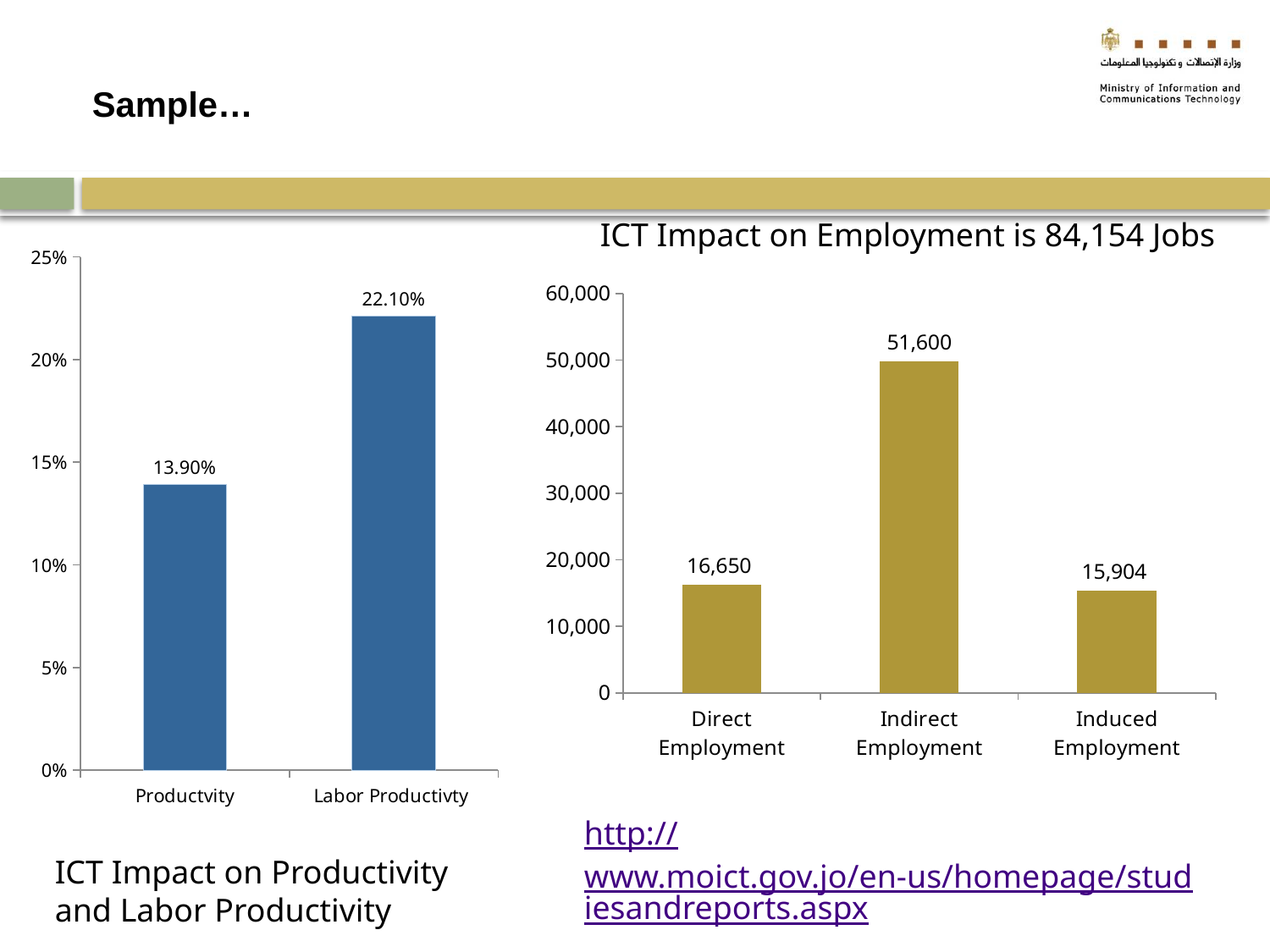
In the right chart (ICT Impact on Employment is 84,154 Jobs), what is the value for Induced Employment? 15,904 In the left chart (ICT Impact on Productivity and Labor Productivity), what is the difference between Labor Productivty and Productvity? 8.20% In the right chart (ICT Impact on Employment is 84,154 Jobs), what is the value for Indirect Employment? 51,600 In the left chart (ICT Impact on Productivity and Labor Productivity), what is the value for Labor Productivty? 22.10% In the right chart (ICT Impact on Employment is 84,154 Jobs), which category has the lowest value? Induced Employment What kind of chart is the right chart (ICT Impact on Employment is 84,154 Jobs)? Bar chart In the left chart (ICT Impact on Productivity and Labor Productivity), how many categories are shown? 2 In the right chart (ICT Impact on Employment is 84,154 Jobs), what is the value for Direct Employment? 16,650 In the left chart (ICT Impact on Productivity and Labor Productivity), which category has the higher value? Labor Productivty In the right chart (ICT Impact on Employment is 84,154 Jobs), what is the difference between Indirect Employment and Direct Employment? 34,950 In the right chart (ICT Impact on Employment is 84,154 Jobs), how many categories are shown? 3 In the left chart (ICT Impact on Productivity and Labor Productivity), what is the value for Productvity? 13.90%